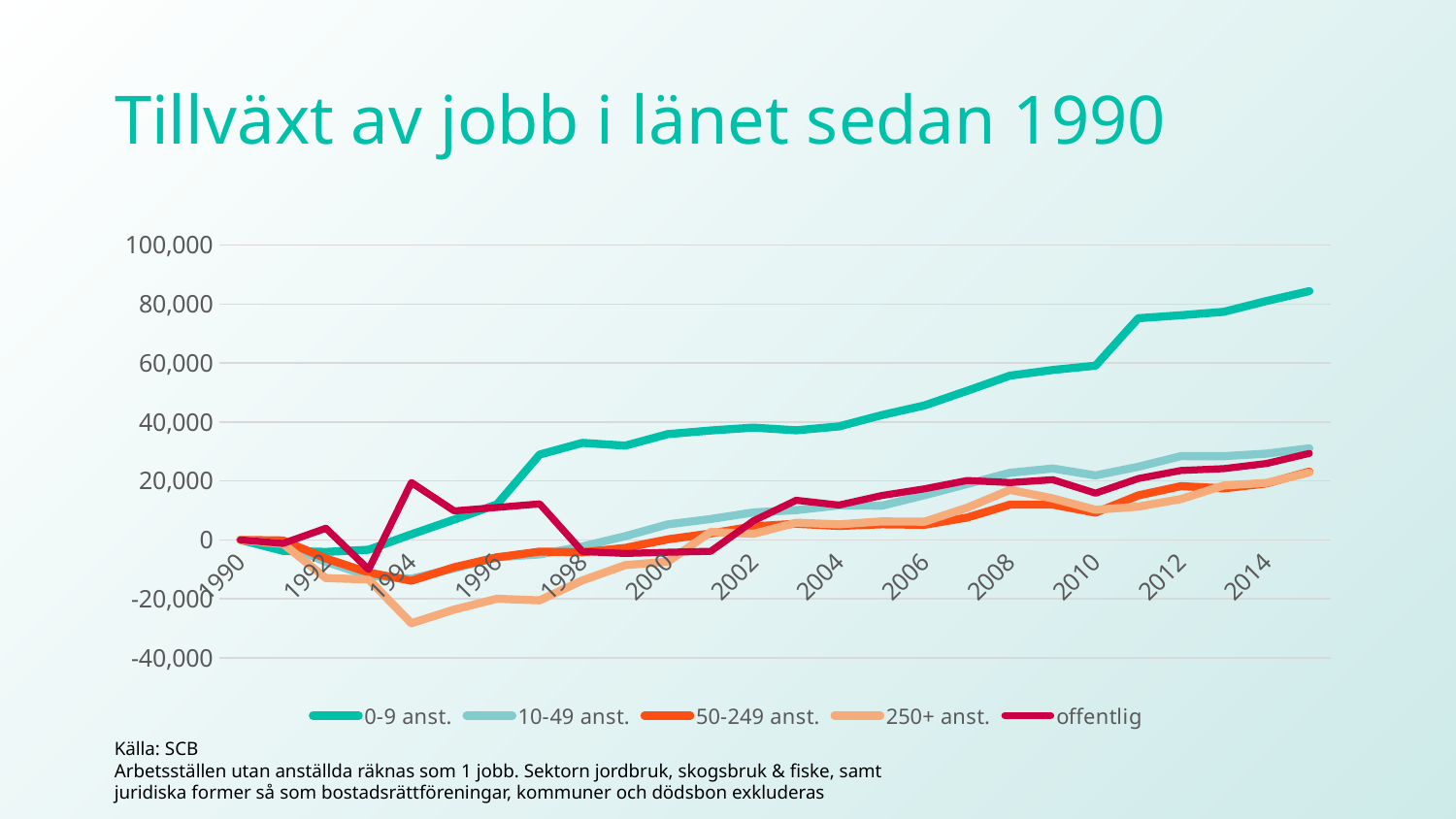
Does the 0-9 anst. series generally rise or fall from 1994 to 2014? rise Is the value for offentlig in 1994 greater or less than 0? greater Which is larger in 2014, the value for 0-9 anst. or the value for offentlig? 0-9 anst. Is the value for 0-9 anst. in 2008 greater or less than 40,000? greater What is the title of the chart? Tillväxt av jobb i länet sedan 1990 Which series has the lowest value in 1994? 250+ anst. What source is cited below the chart? SCB What kind of chart is shown on the slide? line chart Is the value for 250+ anst. in 1994 greater or less than -20,000? less Which series has the highest value in 2014? 0-9 anst. How many series does the legend list? 5